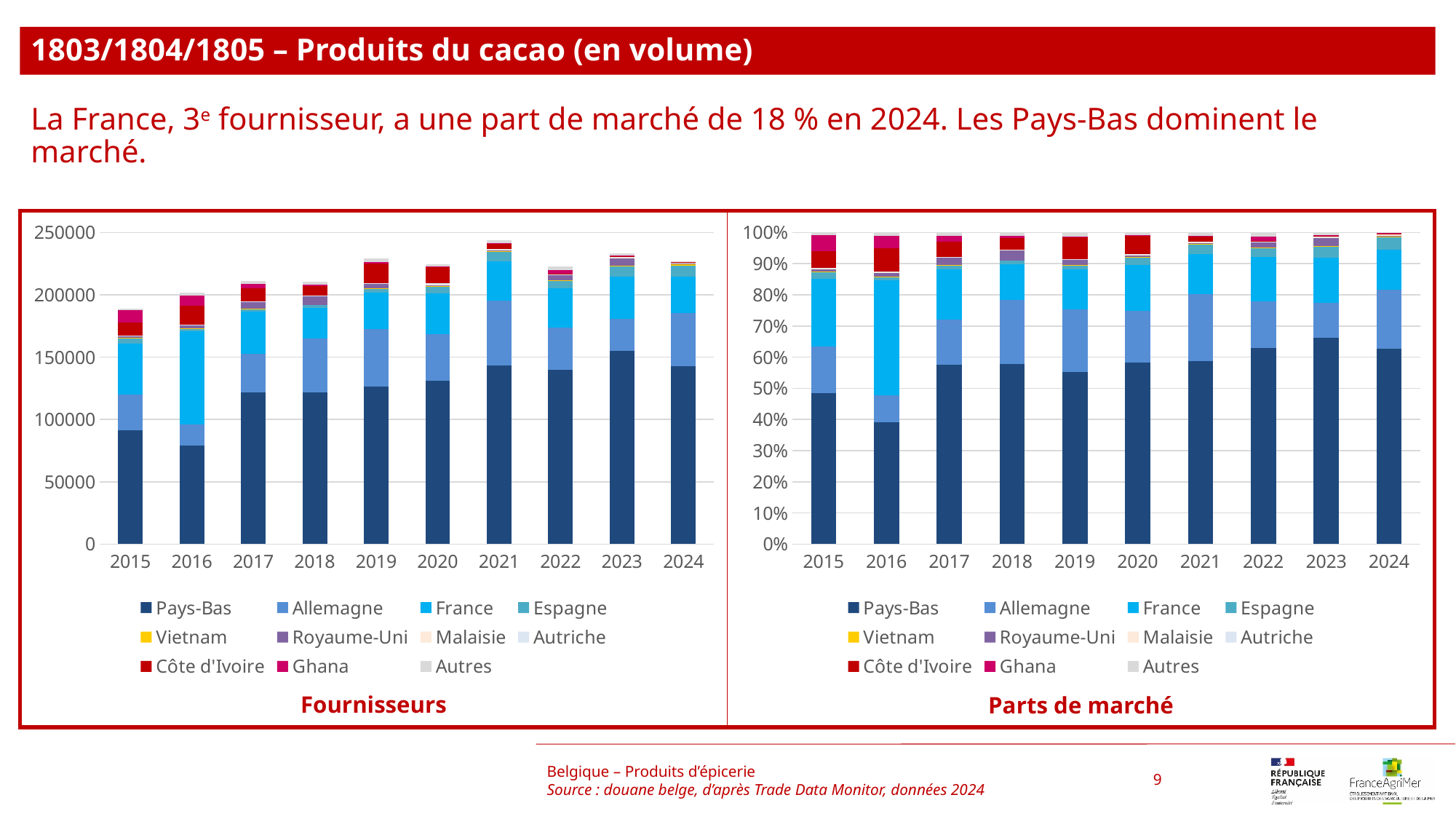
How many years are shown on the x axis of the 'Parts de marché' chart? 10 In the 'Fournisseurs' chart, is the Pays-Bas value larger in 2016 or in 2023? 2023 In the 'Parts de marché' chart, does the Pays-Bas share rise or fall from 2016 to 2023? rise In the 'Parts de marché' chart, is the Pays-Bas share in 2023 greater or less than 60%? greater How many series does the legend of the 'Fournisseurs' chart list? 11 In the 'Fournisseurs' chart, which year has the shortest total bar? 2015 In the 'Parts de marché' chart, which year has the lowest Pays-Bas share? 2016 In the 'Fournisseurs' chart, which year has the tallest total bar? 2021 In the 'Fournisseurs' chart, is the total bar for 2021 greater or less than 200000? greater Which series is shown in dark blue at the bottom of the bars in both charts? Pays-Bas What kind of chart is the 'Fournisseurs' chart on the left? Stacked bar chart In the 'Fournisseurs' chart, is the Pays-Bas value for 2015 greater or less than 100000? less